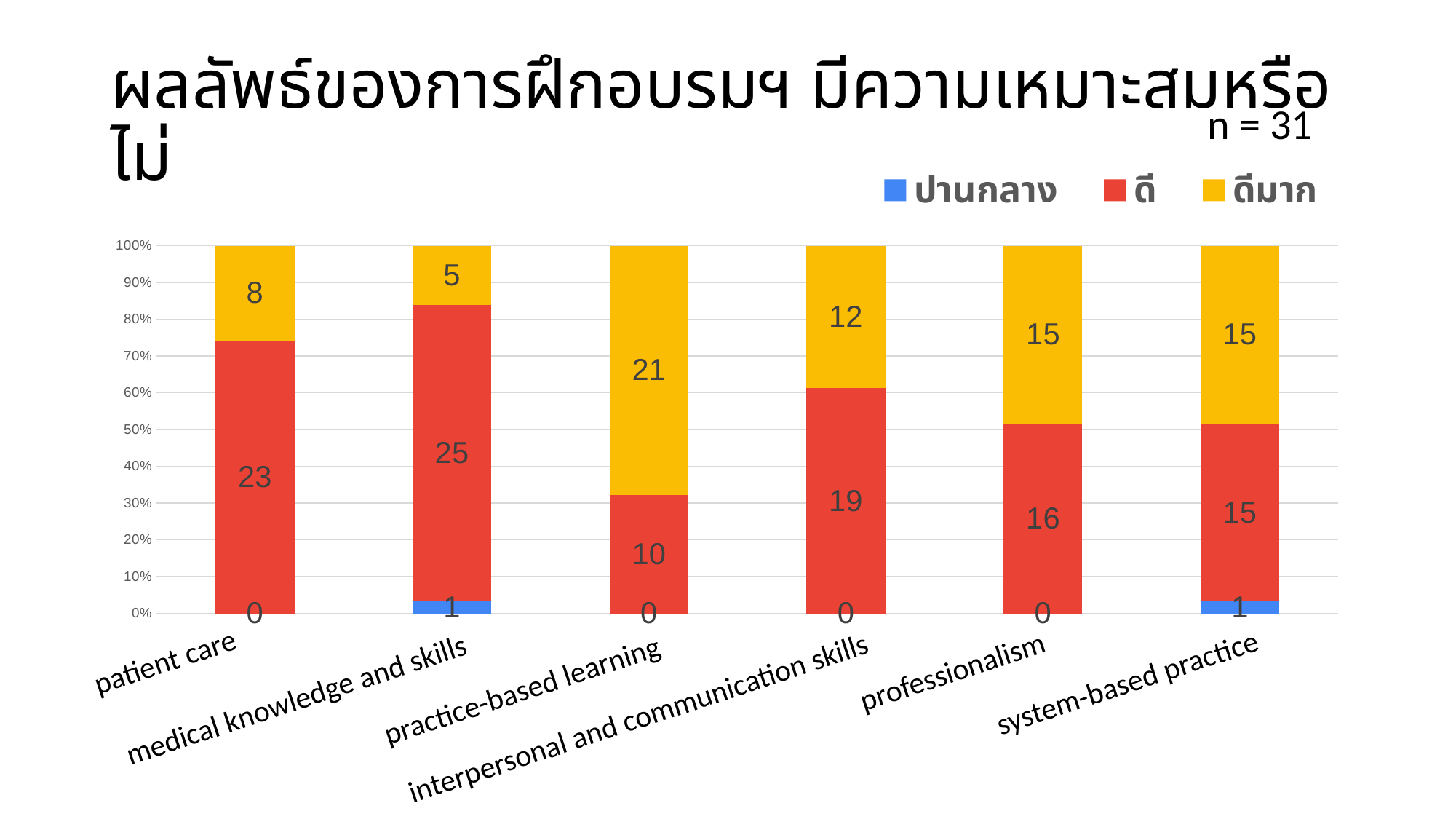
What is the value of ดี for interpersonal and communication skills? 19 Which category has the lowest value for ดีมาก? medical knowledge and skills Which category has the highest value for ดีมาก? practice-based learning How many categories are shown on the x axis? 6 What is the value of ปานกลาง for medical knowledge and skills? 1 What is the total of the stacked bar for system-based practice? 31 What is the value of ดีมาก for practice-based learning? 21 What kind of chart is shown on the slide? stacked bar chart How many series does the legend list? 3 What is the difference between the ดี values for medical knowledge and skills and practice-based learning? 15 What is the value of ดี for patient care? 23 Which is larger: the ดีมาก value for professionalism or the ดีมาก value for interpersonal and communication skills? professionalism